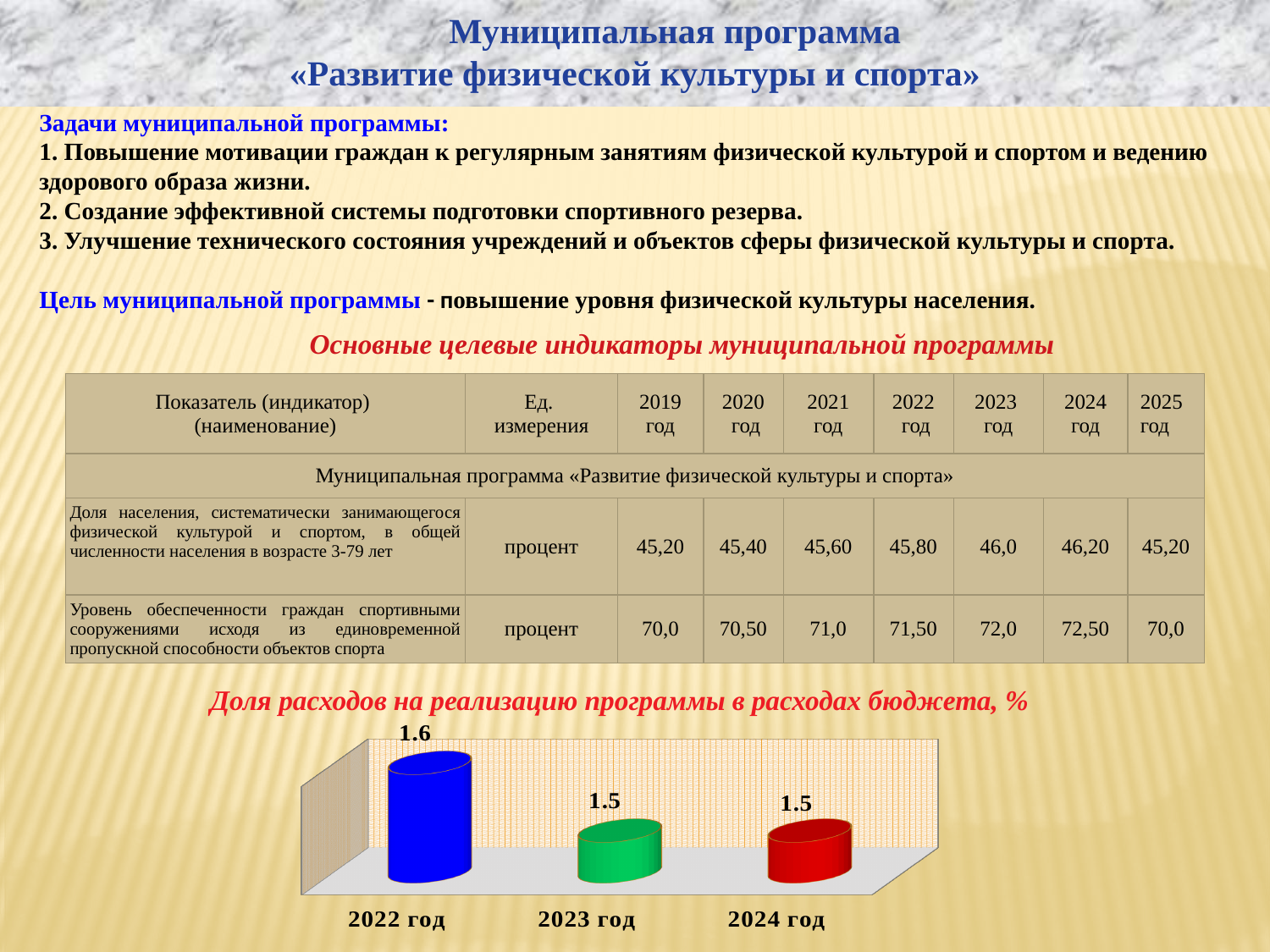
What is the title of the chart at the bottom of the slide? Доля расходов на реализацию программы в расходах бюджета, % What is the difference between the values for 2022 год and 2023 год? 0.1 What is the value for 2024 год in the chart? 1.5 Do the values in the chart rise or fall from 2022 год to 2024 год? Fall Which year has the highest value in the chart? 2022 год How many years are shown in the chart? 3 Which is larger, the value for 2022 год or the value for 2024 год? 2022 год What is the value for 2022 год in the chart 'Доля расходов на реализацию программы в расходах бюджета, %'? 1.6 What kind of chart is shown at the bottom of the slide? Bar chart What is the value for 2023 год in the chart? 1.5 What colour is the bar for 2022 год? Blue